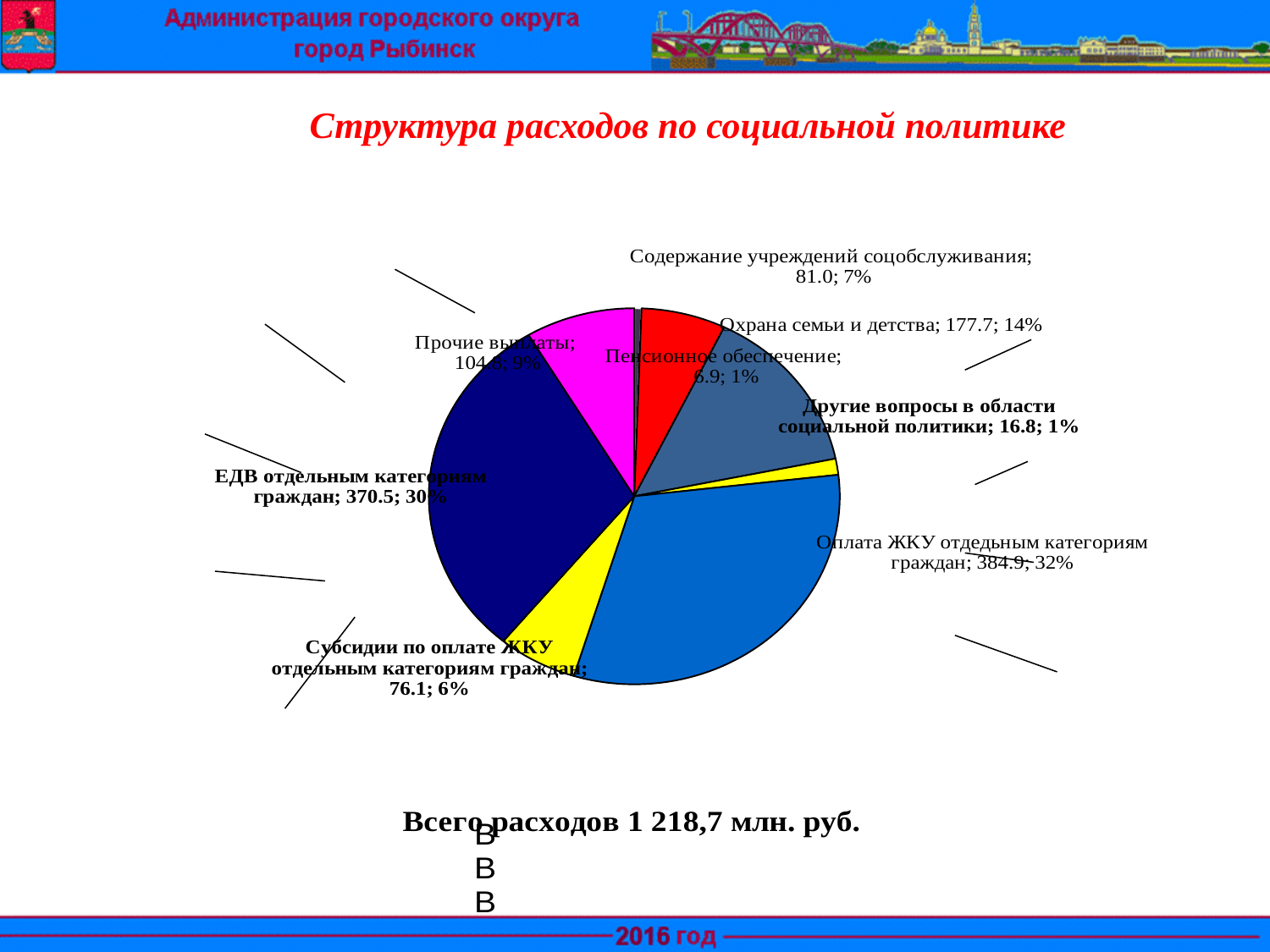
Which is larger, the value for Охрана семьи и детства or the value for Субсидии по оплате ЖКУ отдельным категориям граждан? Охрана семьи и детства What share of the pie does Прочие выплаты represent? 9% What is the value for Оплата ЖКУ отдельным категориям граждан? 384.9 What kind of chart is shown on the slide? pie chart What is the value for Содержание учреждений соцобслуживания? 81.0 What is the title of the chart? Структура расходов по социальной политике How many categories does the pie chart show? 8 What is the difference between the values for Оплата ЖКУ отдельным категориям граждан and ЕДВ отдельным категориям граждан? 14.4 Which category has the smallest slice of the pie? Пенсионное обеспечение Which category has the largest slice of the pie? Оплата ЖКУ отдельным категориям граждан What is the value for ЕДВ отдельным категориям граждан? 370.5 What is the value for Охрана семьи и детства? 177.7